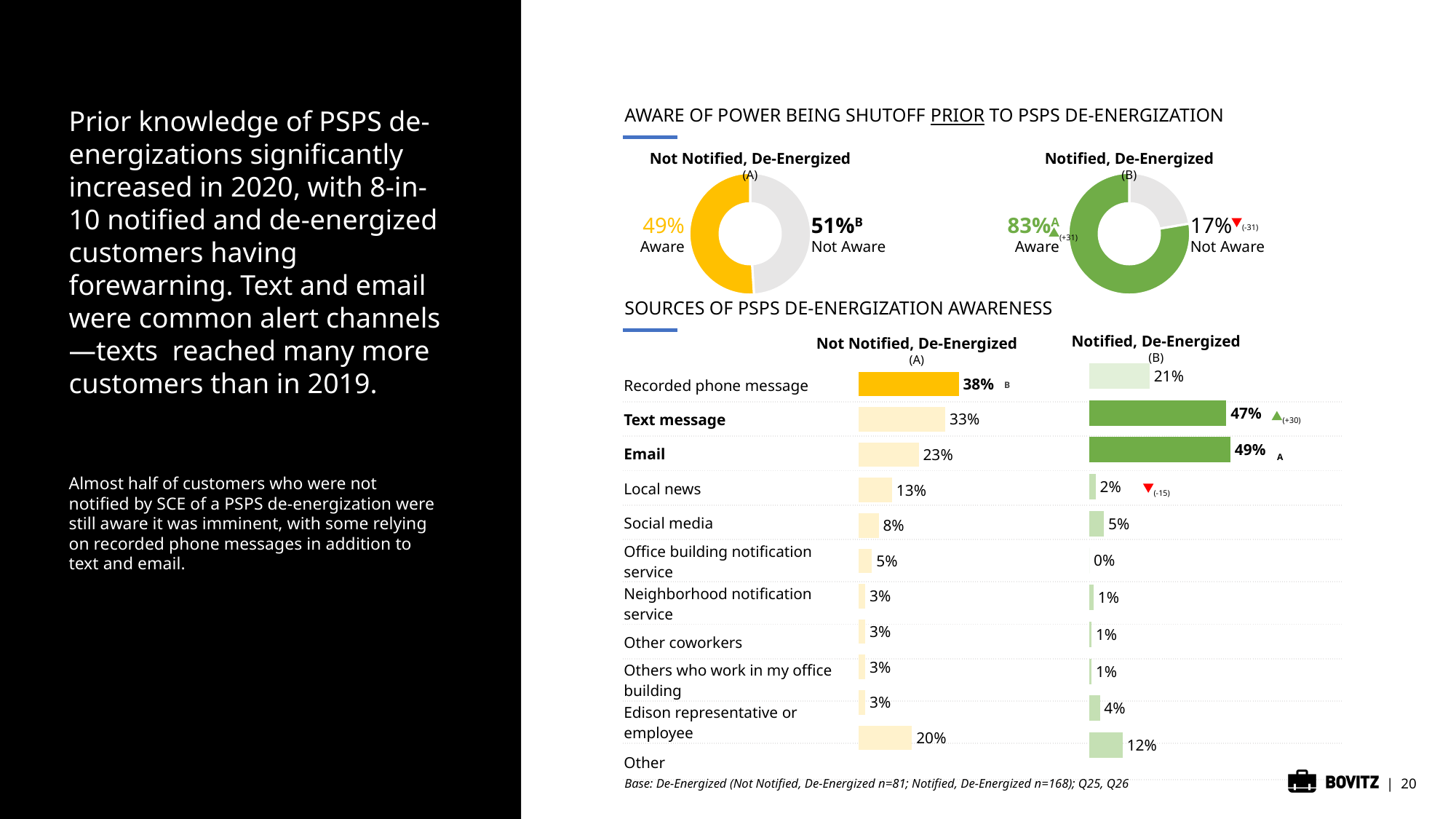
In the awareness donut charts, how many percentage points higher is the Aware share for Notified, De-Energized than for Not Notified, De-Energized? 34 percentage points In the 'Notified, De-Energized' donut chart, what percentage were Not Aware? 17% In the 'Sources of PSPS De-Energization Awareness' chart, which source has the highest value for Not Notified, De-Energized customers? Recorded phone message In the 'Not Notified, De-Energized' donut chart, what percentage were Aware? 49% In the 'Sources of PSPS De-Energization Awareness' chart, what is the value for Recorded phone message among Not Notified, De-Energized customers? 38% In the 'Sources of PSPS De-Energization Awareness' chart, which group has the higher value for Local news, Not Notified or Notified? Not Notified, De-Energized In the 'Sources of PSPS De-Energization Awareness' chart, what is the value for Email among Notified, De-Energized customers? 49% In the 'Sources of PSPS De-Energization Awareness' chart, which source has the highest value for Notified, De-Energized customers? Email In the 'Sources of PSPS De-Energization Awareness' chart, what is the value for Office building notification service among Notified, De-Energized customers? 0% What type of chart is used to show awareness of power being shut off prior to PSPS de-energization? Donut (pie) chart How many sources are listed in the 'Sources of PSPS De-Energization Awareness' chart? 11 In the 'Sources of PSPS De-Energization Awareness' chart, what is the difference in Text message between Notified, De-Energized and Not Notified, De-Energized customers? 14 percentage points